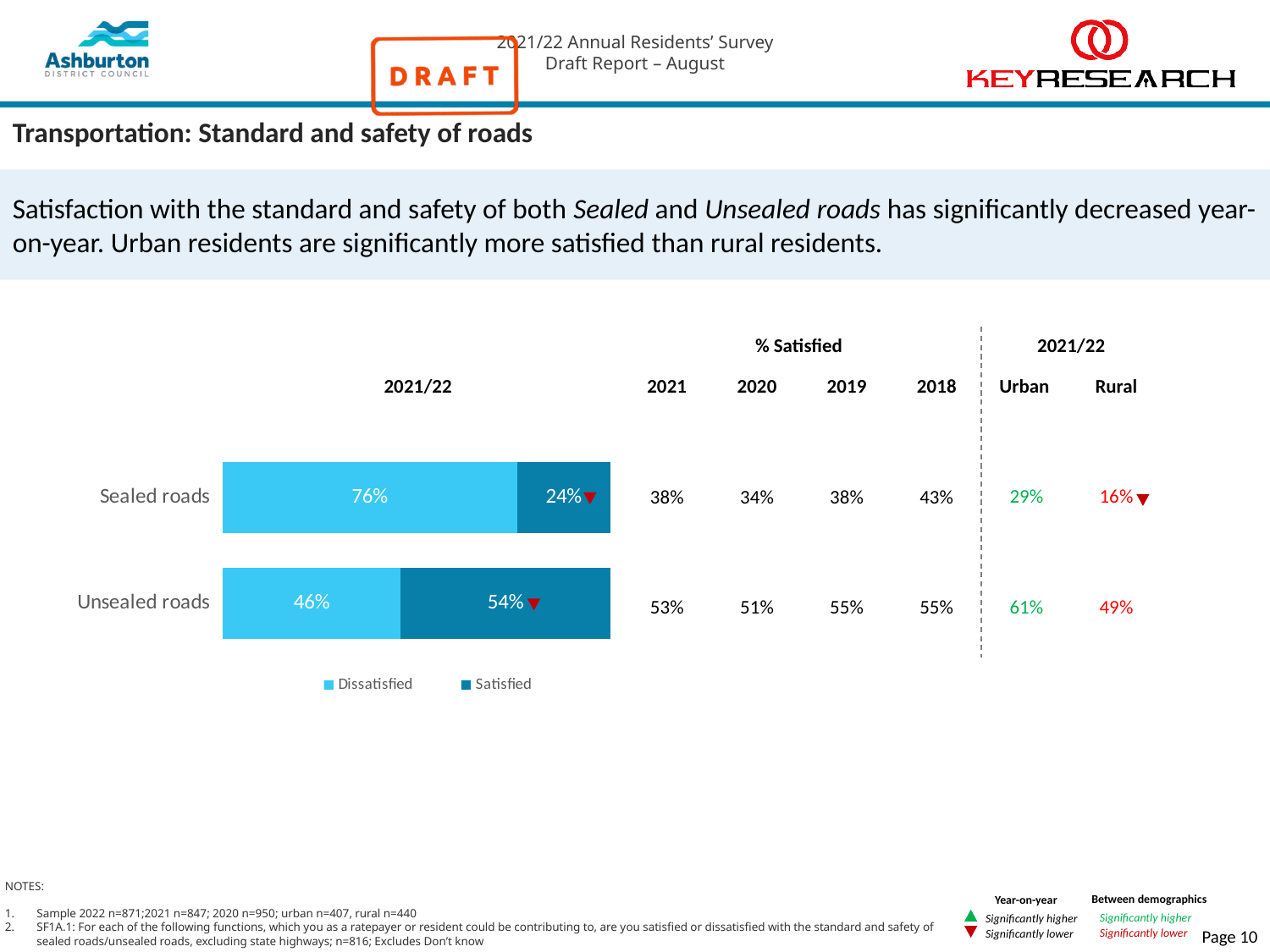
How many categories are plotted in the 2021/22 bar chart? 2 In the 2021/22 chart, what percentage of residents are dissatisfied with Unsealed roads? 46% Is the Dissatisfied percentage for Sealed roads larger or smaller than the Dissatisfied percentage for Unsealed roads? Larger What type of chart is shown on the slide? Stacked bar chart In the 2021/22 chart, what percentage of residents are satisfied with Unsealed roads? 54% What is the difference between the Satisfied percentages for Unsealed roads and Sealed roads in the 2021/22 chart? 30 percentage points What are the two legend entries in the 2021/22 chart? Dissatisfied and Satisfied In the 2021/22 chart, what percentage of residents are dissatisfied with Sealed roads? 76% Which category has the higher Satisfied percentage in the 2021/22 chart? Unsealed roads Which category has the lower Dissatisfied percentage in the 2021/22 chart? Unsealed roads How many series does the legend of the 2021/22 chart list? 2 In the 2021/22 chart, what percentage of residents are satisfied with Sealed roads? 24%